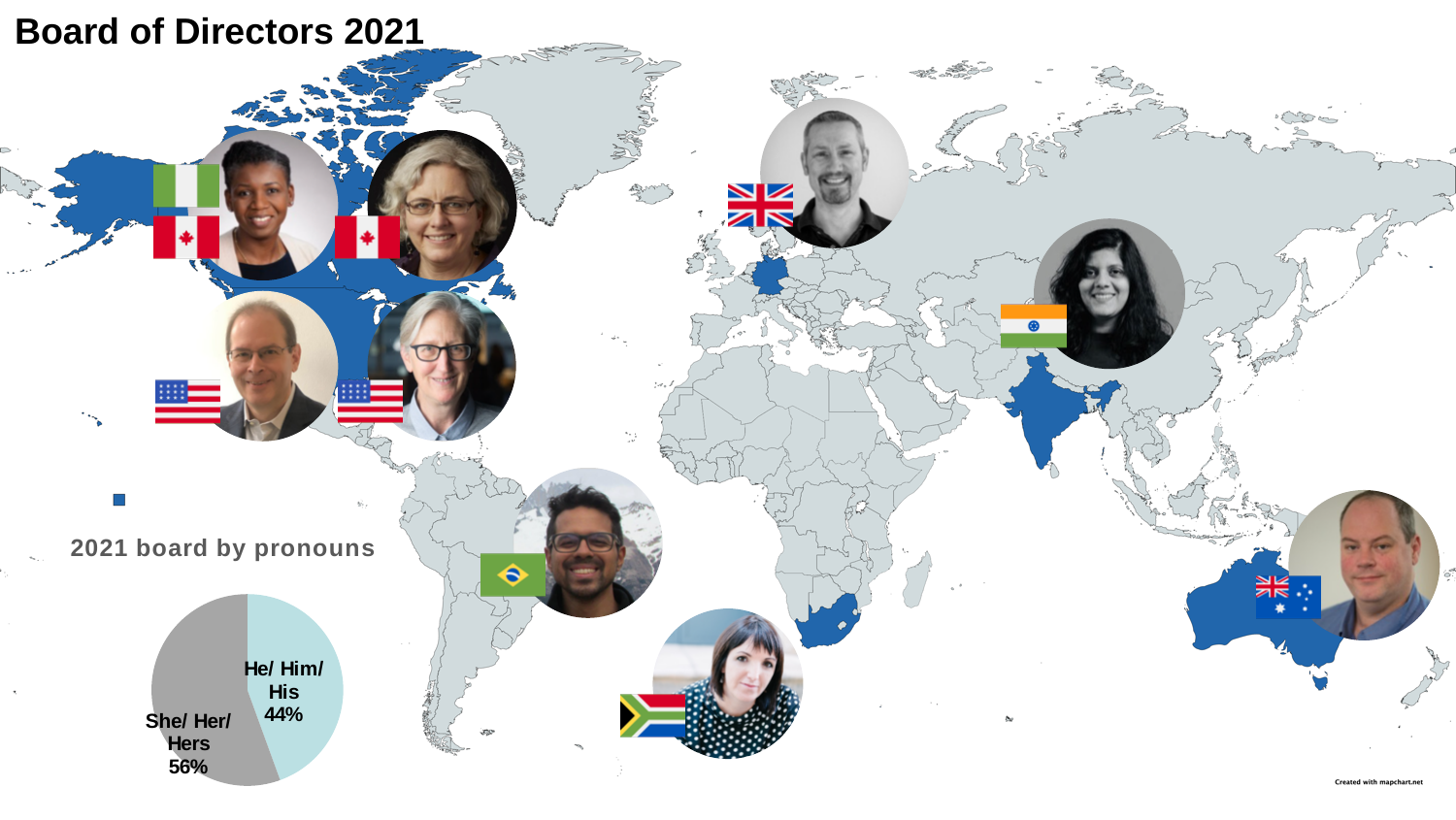
Is the He/ Him/ His share in the "2021 board by pronouns" pie chart greater or less than 50%? less What kind of chart is shown under the heading "2021 board by pronouns"? Pie chart In the "2021 board by pronouns" pie chart, how many percentage points larger is the She/ Her/ Hers slice than the He/ Him/ His slice? 12 In the "2021 board by pronouns" pie chart, what colour is the She/ Her/ Hers slice? Grey Which slice of the "2021 board by pronouns" pie chart is the smallest? He/ Him/ His Which slice of the "2021 board by pronouns" pie chart is the largest? She/ Her/ Hers What is the title of the pie chart on the slide? 2021 board by pronouns How many slices does the "2021 board by pronouns" pie chart have? 2 In the "2021 board by pronouns" pie chart, what share is labelled He/ Him/ His? 44% In the "2021 board by pronouns" pie chart, what share is labelled She/ Her/ Hers? 56% In the "2021 board by pronouns" pie chart, which is larger: He/ Him/ His or She/ Her/ Hers? She/ Her/ Hers